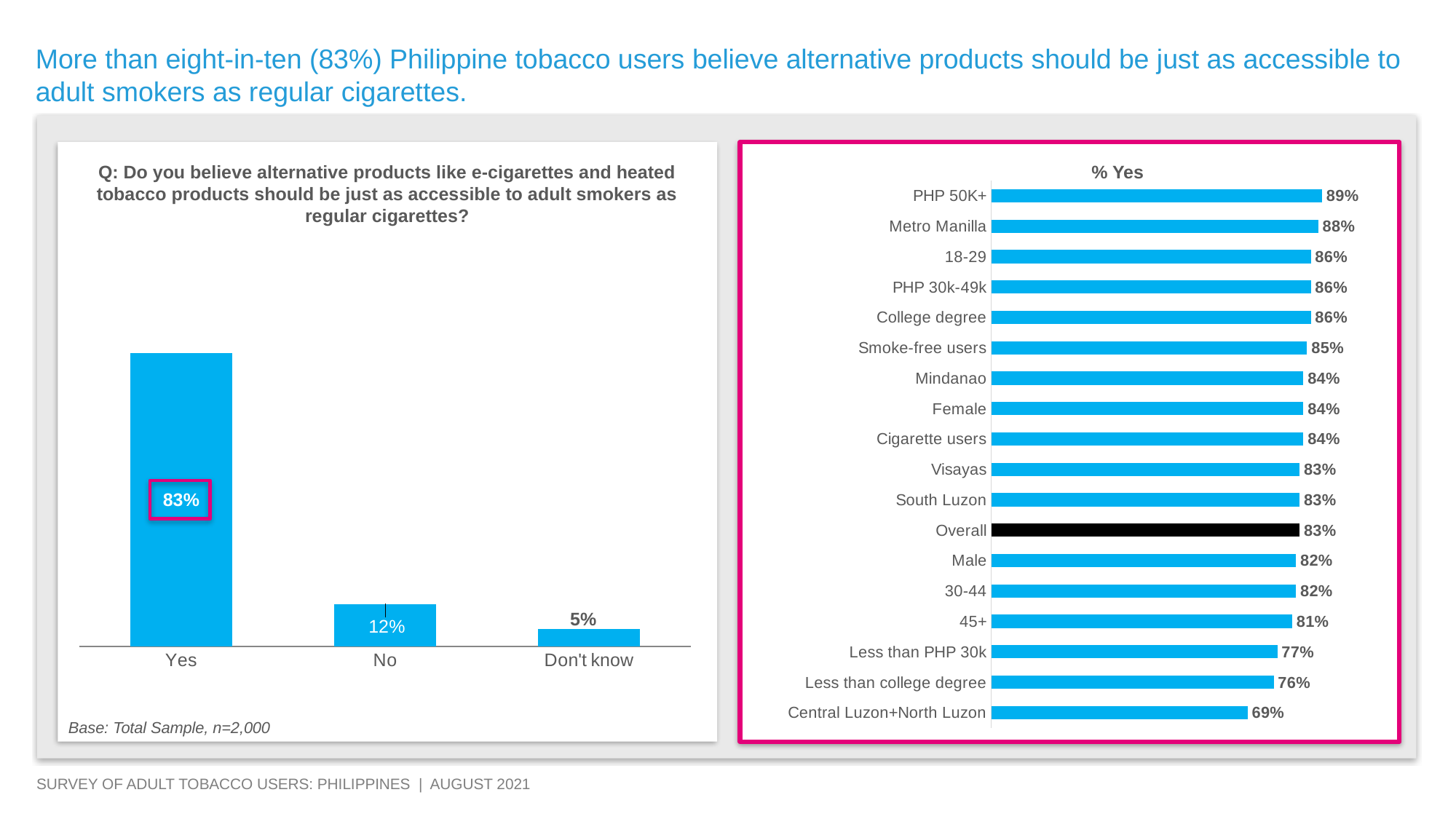
In the '% Yes' chart, what is the difference between the values for PHP 50K+ and Less than PHP 30k? 12 percentage points In the '% Yes' chart, what is the value for Metro Manilla? 88% In the '% Yes' chart, which group has the lowest value? Central Luzon+North Luzon How many response categories are shown in the left chart? 3 In the '% Yes' chart, which is larger: the value for Female or the value for Male? Female What type of chart is the '% Yes' chart on the right? Bar chart In the left chart, which response category has the lowest value? Don't know In the left chart, what percentage of respondents answered 'Don't know'? 5% In the left chart, what is the difference between the 'Yes' and 'No' percentages? 71 percentage points In the '% Yes' chart, which group has the highest value? PHP 50K+ In the '% Yes' chart, what is the value for Less than college degree? 76% In the left chart, what percentage of respondents answered 'Yes'? 83%